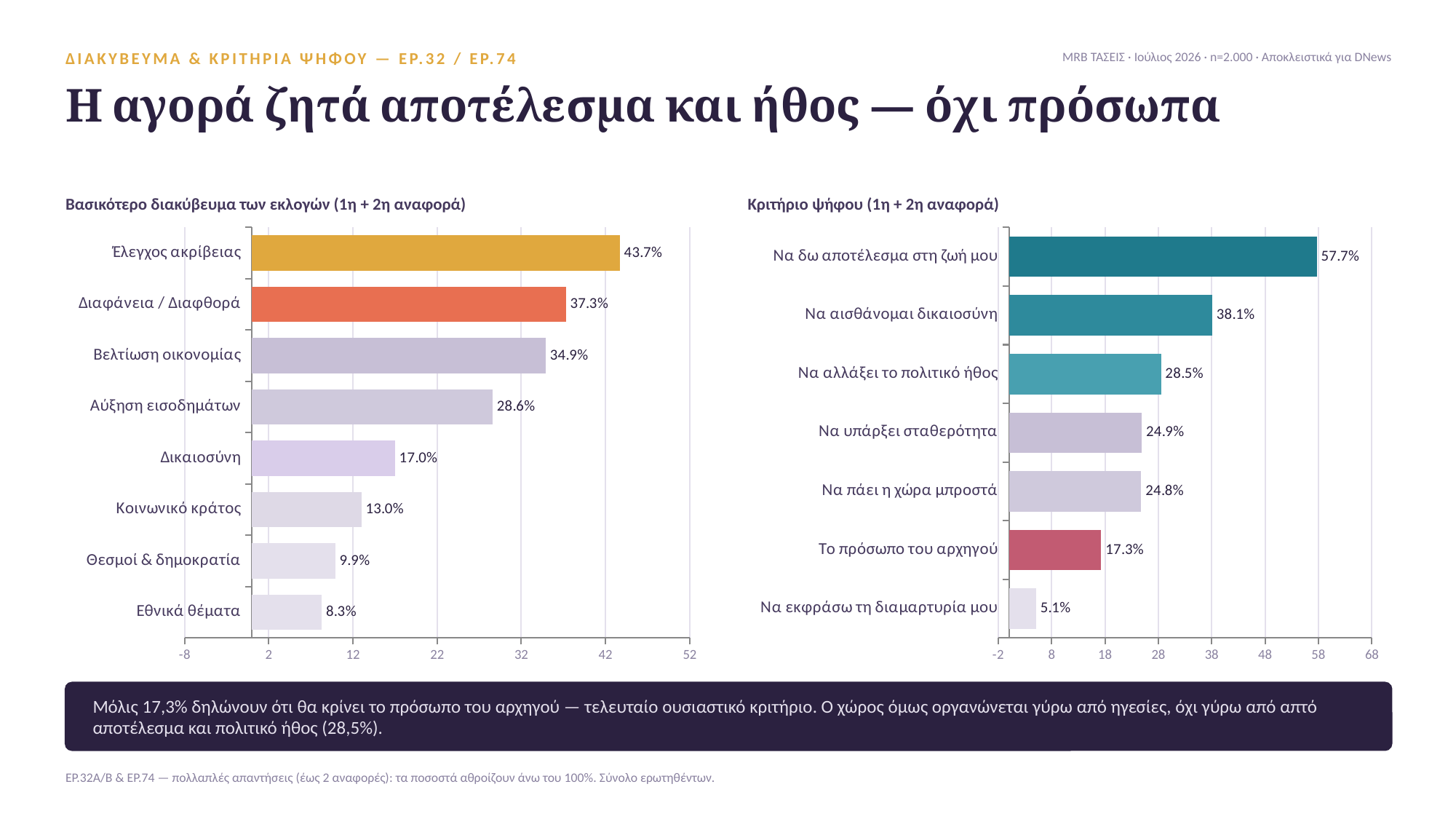
In the chart titled 'Κριτήριο ψήφου (1η + 2η αναφορά)', which category has the highest value? Να δω αποτέλεσμα στη ζωή μου In the chart titled 'Κριτήριο ψήφου (1η + 2η αναφορά)', what is the difference between 'Να δω αποτέλεσμα στη ζωή μου' and 'Να αισθάνομαι δικαιοσύνη'? 19.6% In the chart titled 'Κριτήριο ψήφου (1η + 2η αναφορά)', is the value for 'Να αλλάξει το πολιτικό ήθος' greater or less than 18? greater In the chart titled 'Βασικότερο διακύβευμα των εκλογών (1η + 2η αναφορά)', which is larger: 'Δικαιοσύνη' or 'Κοινωνικό κράτος'? Δικαιοσύνη How many categories are shown in the chart titled 'Βασικότερο διακύβευμα των εκλογών (1η + 2η αναφορά)'? 8 In the chart titled 'Κριτήριο ψήφου (1η + 2η αναφορά)', what is the value for 'Να εκφράσω τη διαμαρτυρία μου'? 5.1% In the chart titled 'Βασικότερο διακύβευμα των εκλογών (1η + 2η αναφορά)', what is the difference between 'Έλεγχος ακρίβειας' and 'Διαφάνεια / Διαφθορά'? 6.4% How many categories are shown in the chart titled 'Κριτήριο ψήφου (1η + 2η αναφορά)'? 7 In the chart titled 'Βασικότερο διακύβευμα των εκλογών (1η + 2η αναφορά)', which category has the lowest value? Εθνικά θέματα In the chart titled 'Βασικότερο διακύβευμα των εκλογών (1η + 2η αναφορά)', what is the value for 'Έλεγχος ακρίβειας'? 43.7% In the chart titled 'Κριτήριο ψήφου (1η + 2η αναφορά)', what is the value for 'Το πρόσωπο του αρχηγού'? 17.3% What type of chart is the chart titled 'Κριτήριο ψήφου (1η + 2η αναφορά)'? Bar chart